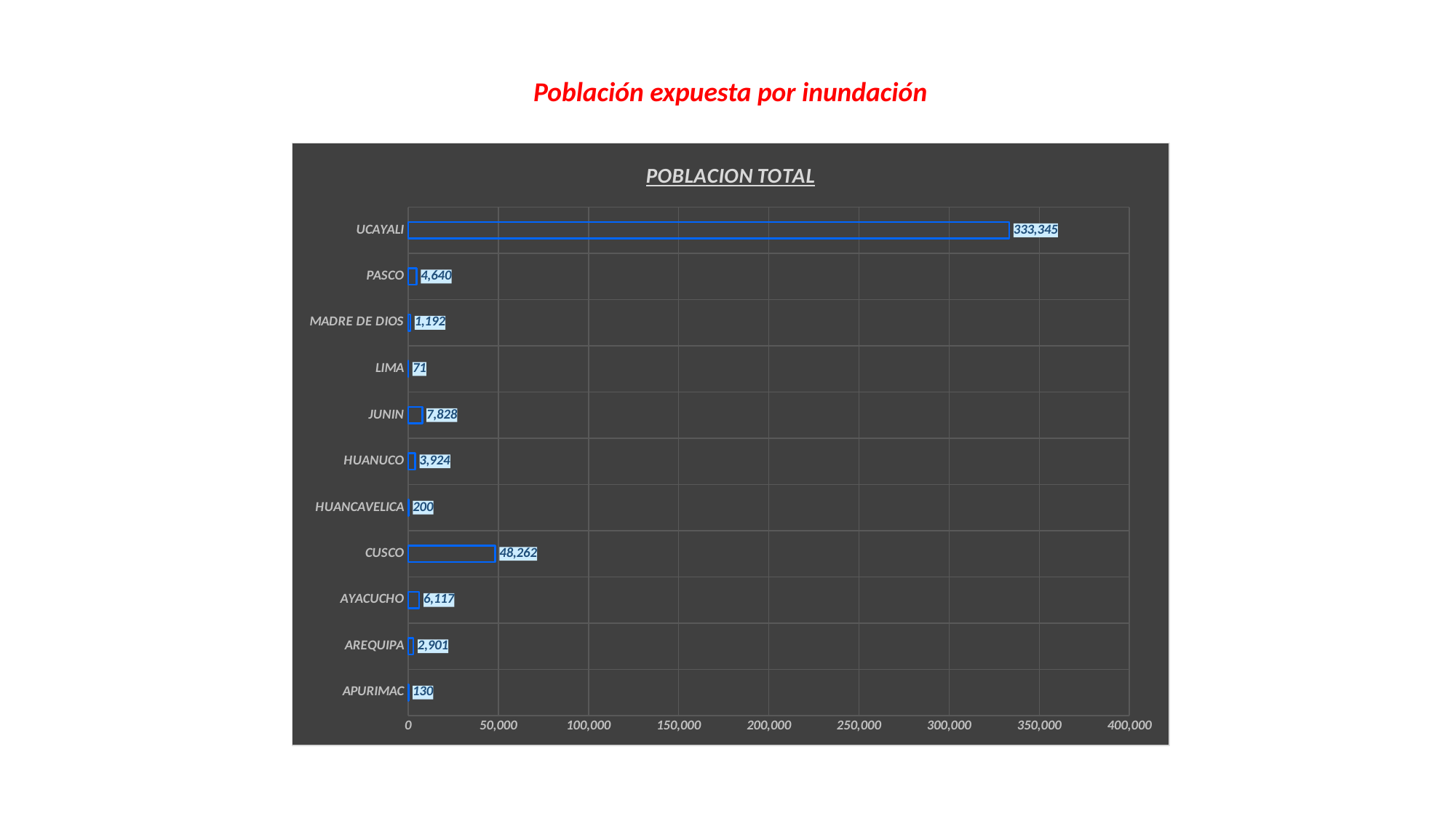
Is the value for CUSCO greater or less than 50,000? less What is the difference between the values for UCAYALI and CUSCO? 285,083 What kind of chart is shown? bar chart What is the value for CUSCO? 48,262 Which category has the highest value? UCAYALI What is the value for JUNIN? 7,828 What is the value for LIMA? 71 Which is larger, the value for PASCO or the value for HUANUCO? PASCO What is the title of the chart? POBLACION TOTAL What is the value for UCAYALI? 333,345 How many categories are shown on the chart? 11 Which category has the lowest value? LIMA